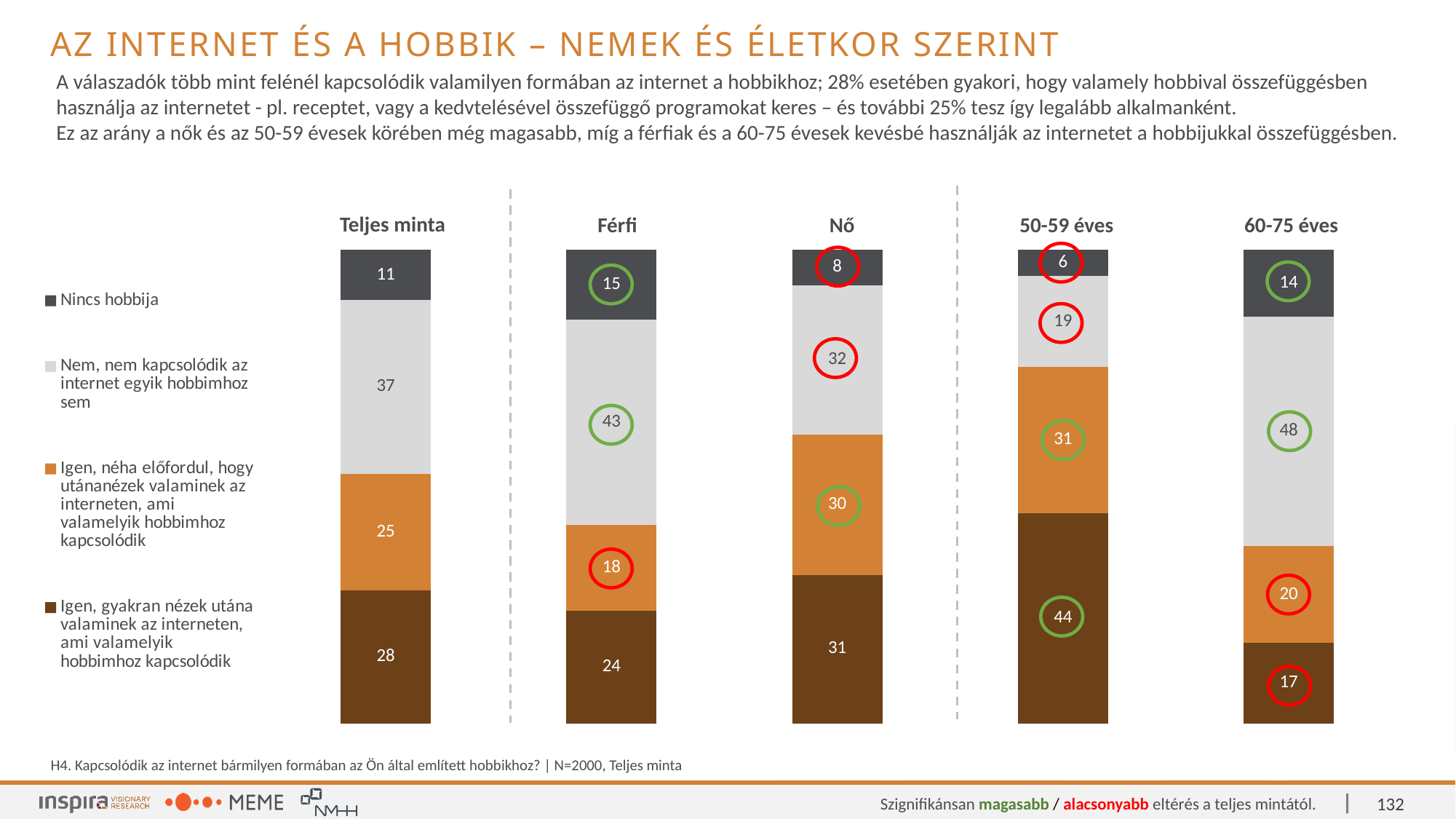
What is the difference between the "Nem, nem kapcsolódik az internet egyik hobbimhoz sem" values for Férfi and Nő? 11 What is the value for "Igen, néha előfordul, hogy utánanézek valaminek az interneten, ami valamelyik hobbimhoz kapcsolódik" in the Férfi bar? 18 How many groups (bars) are shown in the chart? 5 Which group has the highest value for "Igen, gyakran nézek utána valaminek az interneten, ami valamelyik hobbimhoz kapcsolódik"? 50-59 éves What is the value for "Nem, nem kapcsolódik az internet egyik hobbimhoz sem" in the 60-75 éves bar? 48 How many series does the legend list? 4 What is the value for "Igen, gyakran nézek utána valaminek az interneten, ami valamelyik hobbimhoz kapcsolódik" in the Teljes minta bar? 28 What kind of chart is shown on the slide? Stacked bar chart What is the value for "Nincs hobbija" in the Nő bar? 8 What is the total of the 50-59 éves stacked bar? 100 Which group has the lowest value for "Nincs hobbija"? 50-59 éves Which is larger: the "Igen, gyakran nézek utána" value for Nő or for 60-75 éves? Nő